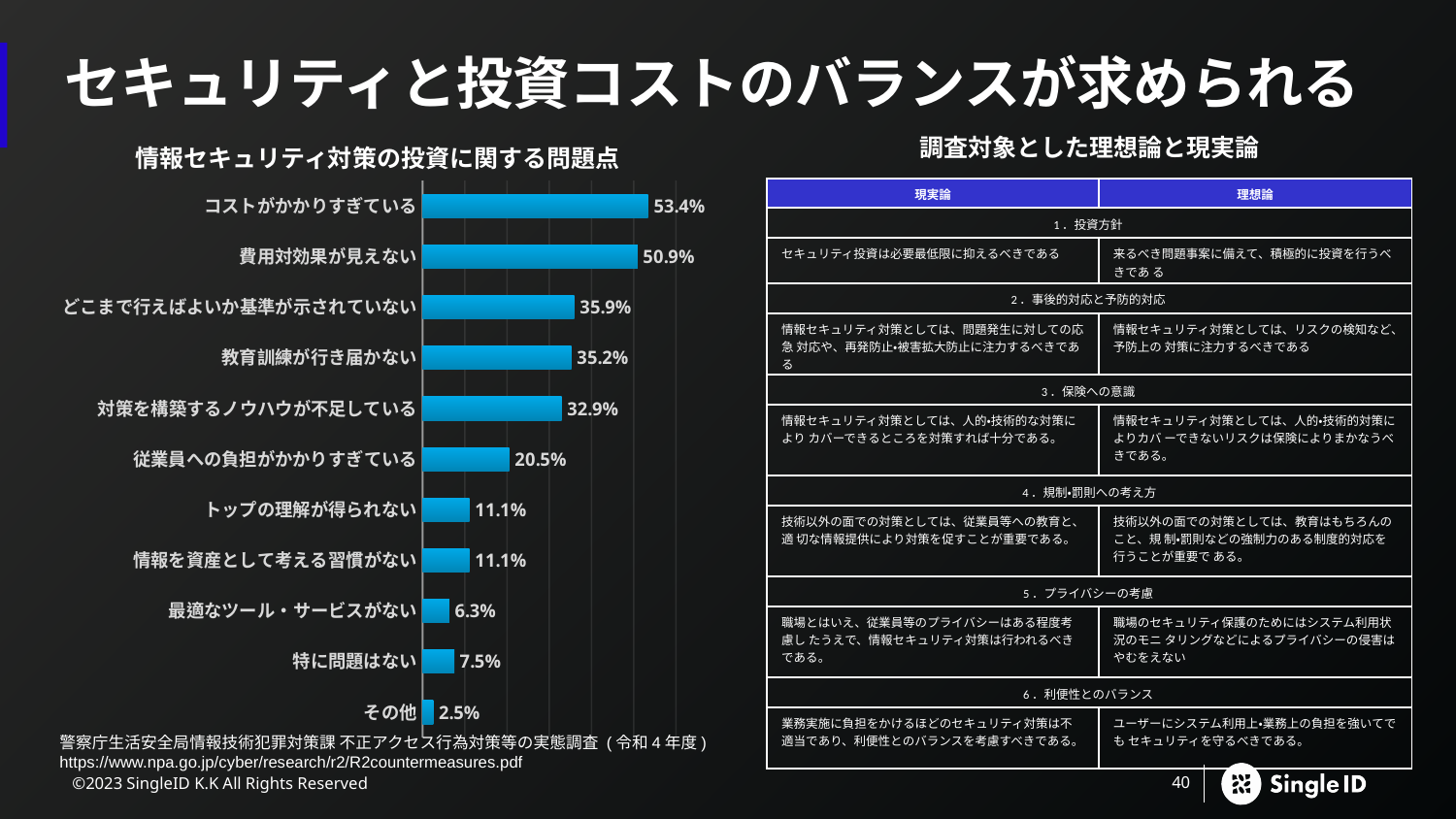
「最適なツール・サービスがない」と「特に問題はない」では、どちらの値が大きいですか？ 特に問題はない 「対策を構築するノウハウが不足している」と「従業員への負担がかかりすぎている」の差はいくつですか？ 12.4% 「コストがかかりすぎている」の値はいくつですか？ 53.4% 最も値が小さい項目はどれですか？ その他 グラフには項目がいくつありますか？ 11 「従業員への負担がかかりすぎている」の値はいくつですか？ 20.5% 最も値が大きい項目はどれですか？ コストがかかりすぎている グラフのタイトルは何ですか？ 情報セキュリティ対策の投資に関する問題点 これはどの種類のグラフですか？ 棒グラフ 「教育訓練が行き届かない」の値はいくつですか？ 35.2% 「特に問題はない」の値はいくつですか？ 7.5% 「コストがかかりすぎている」と「費用対効果が見えない」の差はいくつですか？ 2.5%